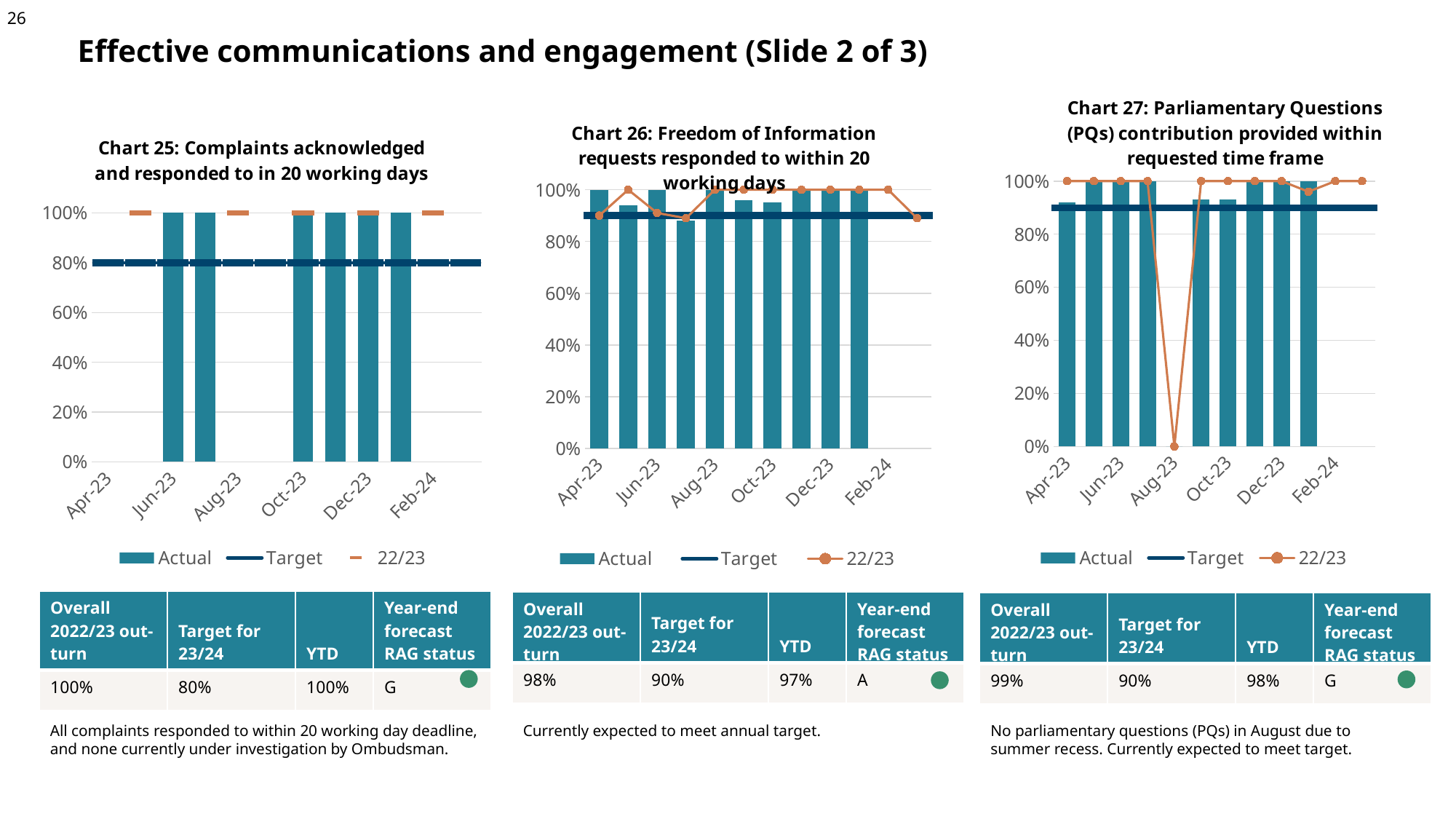
In Chart 26: Freedom of Information requests, which is larger, the Actual value for Apr-23 or for May-23? Apr-23 How many Actual bars are plotted in Chart 25: Complaints acknowledged and responded to in 20 working days? 6 In Chart 27: Parliamentary Questions (PQs) contribution, which month has the lowest 22/23 value? Aug-23 In Chart 27: Parliamentary Questions (PQs) contribution, what is the 22/23 value for Aug-23? 0% In Chart 25: Complaints acknowledged and responded to in 20 working days, what value does the Target line sit at? 80% In Chart 26: Freedom of Information requests responded to within 20 working days, what value does the Target line sit at? 90% How many series does the legend of Chart 26: Freedom of Information requests list? 3 In Chart 26: Freedom of Information requests, is the Actual value for Aug-23 greater or less than 80%? greater How many Actual bars are plotted in Chart 26: Freedom of Information requests responded to within 20 working days? 10 In Chart 25: Complaints acknowledged and responded to in 20 working days, what is the Actual value for Jun-23? 100% In Chart 27: Parliamentary Questions (PQs) contribution, is the Actual value for Sep-23 greater or less than 80%? greater What kind of chart is Chart 25: Complaints acknowledged and responded to in 20 working days? Combination bar and line chart